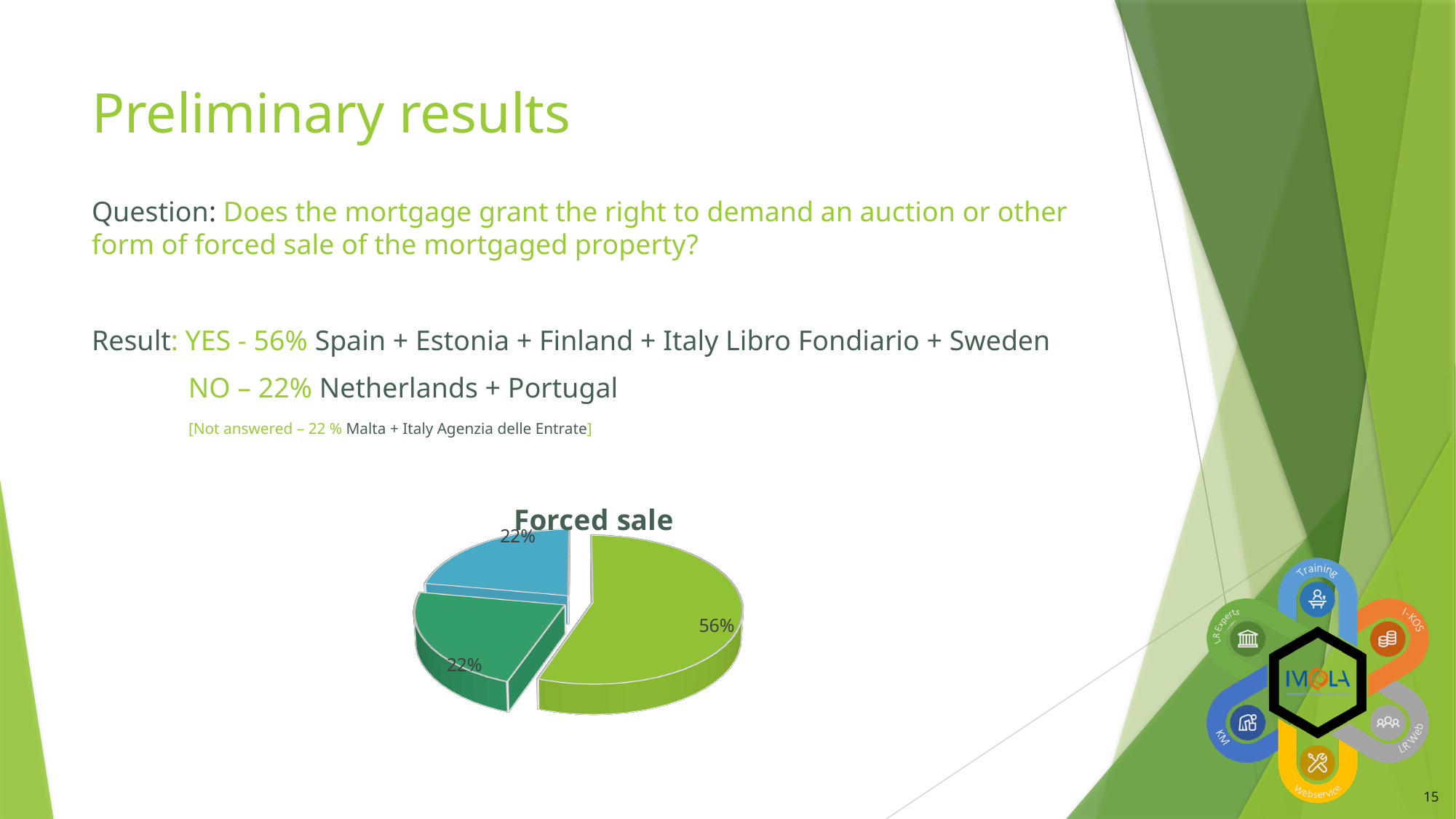
What colour is the slice labelled 56% in the pie chart? light green What is the title of the chart? Forced sale What is the value shown on the largest slice of the pie chart? 56% What value is shown on the light green slice of the pie chart? 56% What value is shown on the teal (dark green) slice of the pie chart? 22% How many slices does the pie chart have? 3 What is the difference between the largest slice and the blue slice of the pie chart? 34% How many slices of the pie chart are labelled 22%? 2 Which is larger in the pie chart, the light green slice or the teal slice? the light green slice What value is shown on the blue slice of the pie chart? 22% Is the largest slice of the pie chart greater or less than 50%? greater What kind of chart is shown on the slide? pie chart